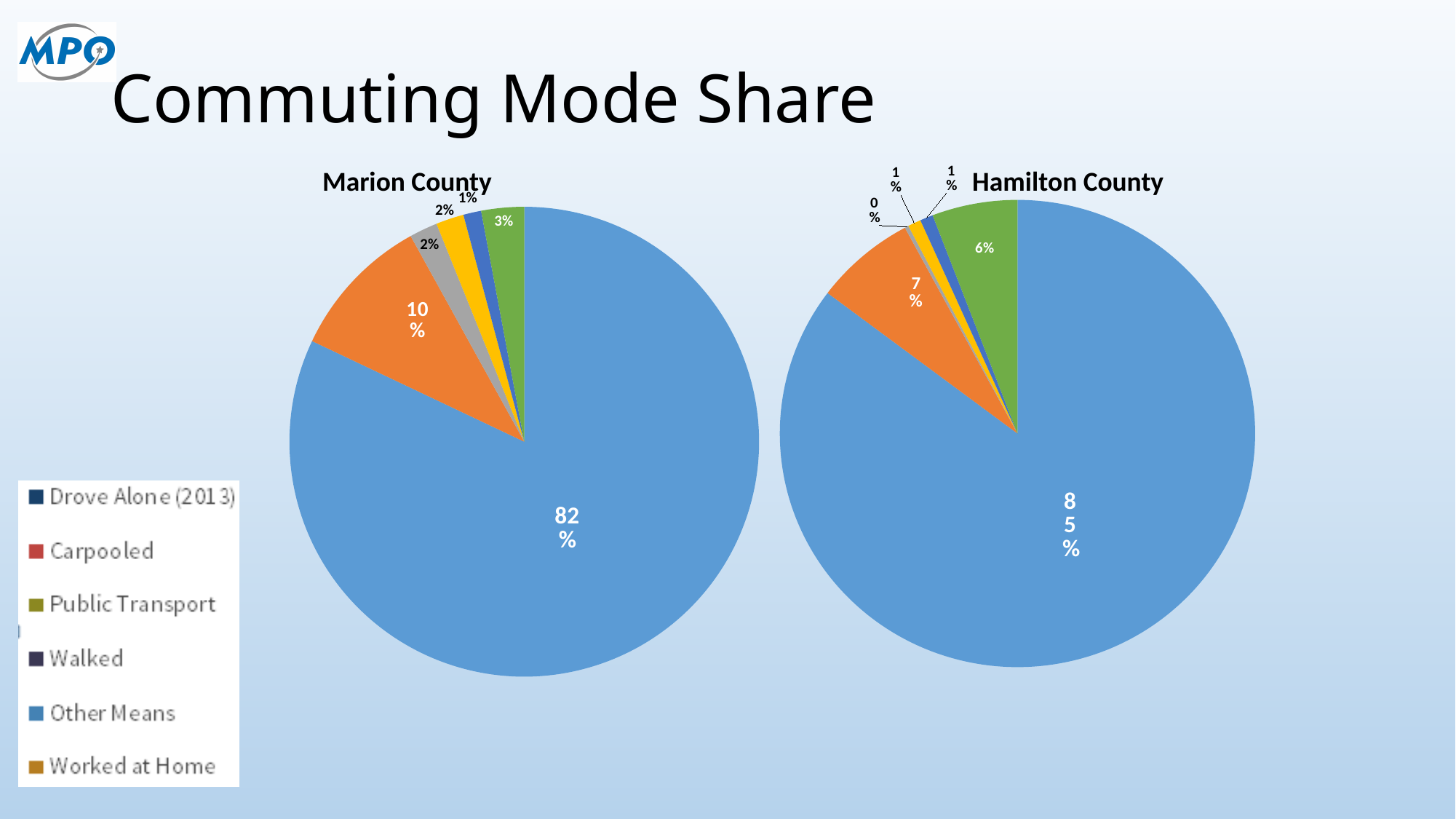
In the Marion County chart, what is the value of the green slice? 3% In the Hamilton County chart, what is the value of the largest slice? 85% Which chart has the larger biggest slice, Marion County or Hamilton County? Hamilton County How many slices does the Marion County pie chart have? 6 How many entries does the legend on the slide list? 6 In the Marion County chart, what is the value of the orange slice? 10% In the Marion County chart, what is the value of the largest slice? 82% What kind of charts are shown on the slide? Pie charts How many slices does the Hamilton County pie chart have? 6 In the Hamilton County chart, what is the value of the green slice? 6% In the Hamilton County chart, what is the value of the orange slice? 7% What is the difference between the largest slice in the Hamilton County chart and the largest slice in the Marion County chart? 3%